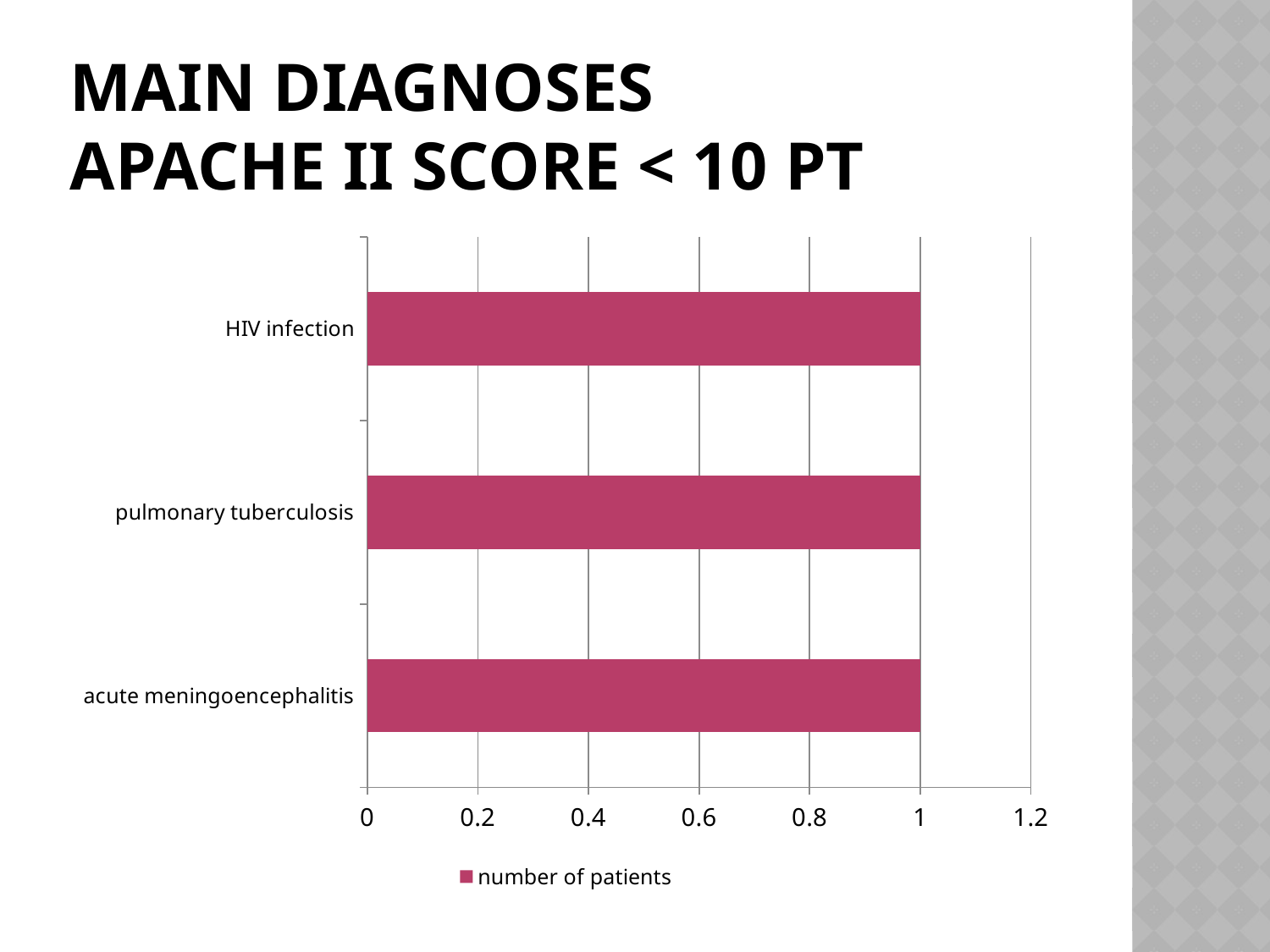
What is the number of patients for HIV infection? 1 What is the title of the slide containing the chart? MAIN DIAGNOSES APACHE II SCORE < 10 PT What is the difference between the number of patients for HIV infection and for pulmonary tuberculosis? 0 What is the number of patients for acute meningoencephalitis? 1 Is the value for HIV infection greater or less than 1.2? less What type of chart is shown on the slide? bar chart How many series does the legend list? 1 Is the value for acute meningoencephalitis greater or less than 0.8? greater What is the name of the series shown in the legend? number of patients How many diagnosis categories are plotted in the chart? 3 What is the number of patients for pulmonary tuberculosis? 1